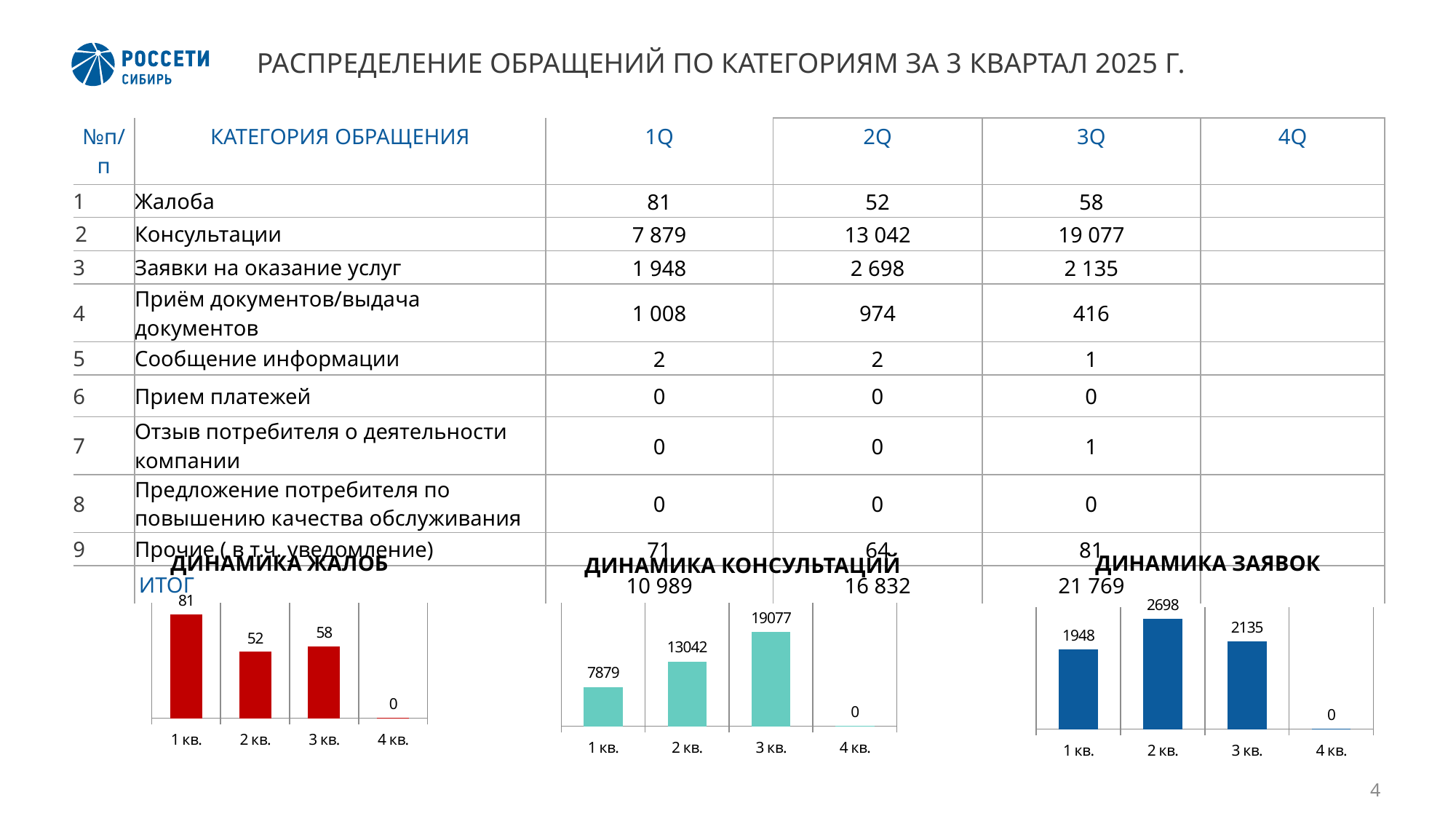
In the chart titled ДИНАМИКА ЖАЛОБ, what is the difference between the values for 3 кв. and 2 кв.? 6 In the chart titled ДИНАМИКА ЖАЛОБ, what is the value for 1 кв.? 81 What kind of chart is the chart titled ДИНАМИКА ЗАЯВОК? bar chart What colour are the bars in the chart titled ДИНАМИКА ЖАЛОБ? red In the chart titled ДИНАМИКА КОНСУЛЬТАЦИЙ, what is the value for 3 кв.? 19077 In the chart titled ДИНАМИКА КОНСУЛЬТАЦИЙ, do the values rise or fall from 1 кв. to 3 кв.? rise In the chart titled ДИНАМИКА ЗАЯВОК, which is larger, the value for 1 кв. or the value for 3 кв.? 3 кв. In the chart titled ДИНАМИКА ЖАЛОБ, which quarter has the highest value? 1 кв. How many quarters are shown on the x axis of the chart titled ДИНАМИКА ЖАЛОБ? 4 In the chart titled ДИНАМИКА ЗАЯВОК, what is the value for 2 кв.? 2698 In the chart titled ДИНАМИКА КОНСУЛЬТАЦИЙ, what is the difference between the values for 2 кв. and 1 кв.? 5163 In the chart titled ДИНАМИКА ЗАЯВОК, which quarter has the highest value? 2 кв.